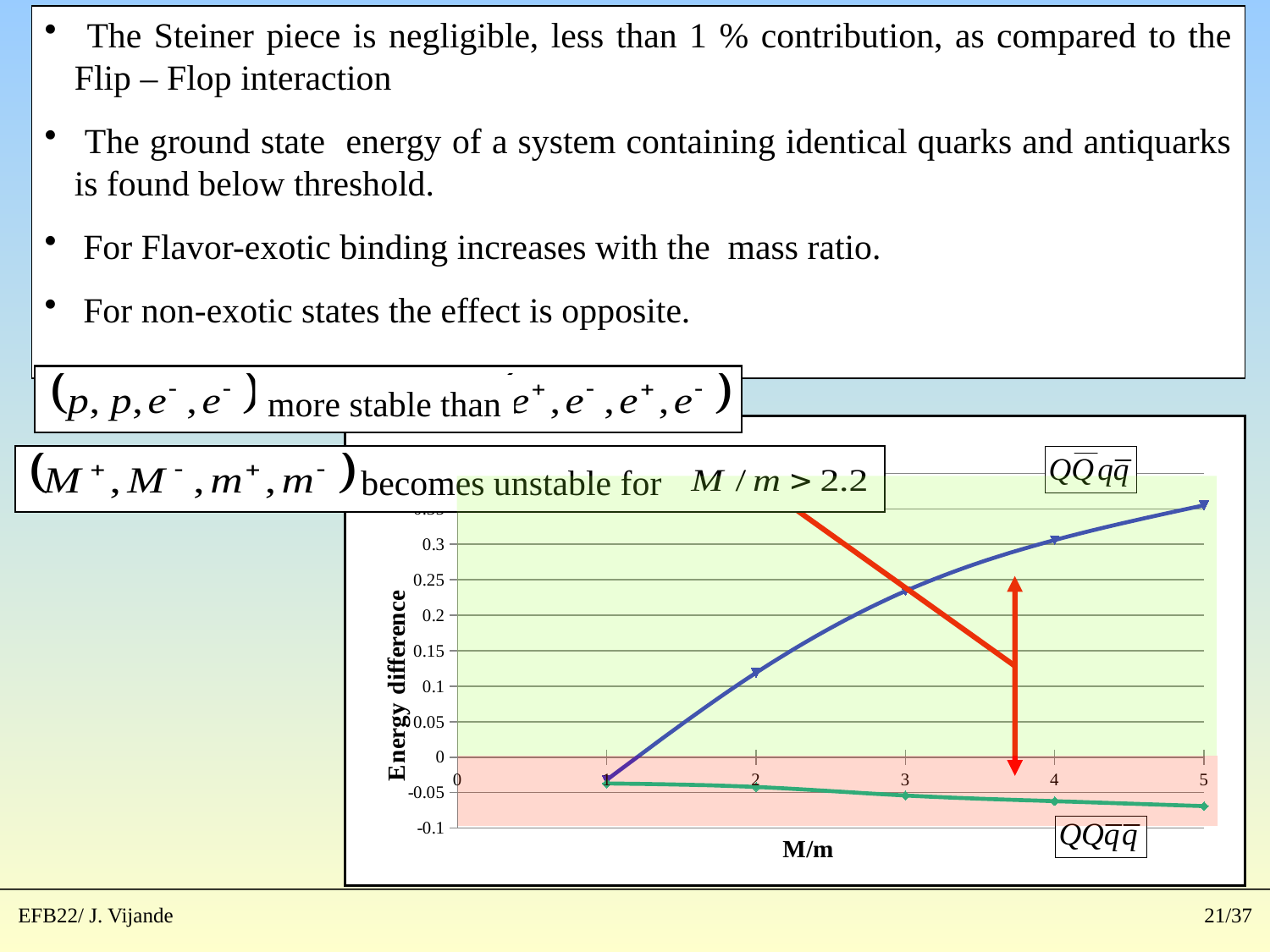
Is the value of the green curve at M/m = 5 greater or less than 0? less Is the value of the blue curve at M/m = 3 greater or less than 0.2? greater Does the green curve rise or fall as M/m increases? fall How many data points are plotted on the blue curve? 5 What is the label of the x axis of the chart? M/m How many curves are plotted on the chart? 2 Is the value of the blue curve at M/m = 5 greater or less than 0.3? greater At M/m = 5, which curve has the larger value, the blue or the green? blue Does the blue curve rise or fall as M/m increases? rise What kind of chart is shown on the slide? line chart What is the label of the y axis of the chart? Energy difference